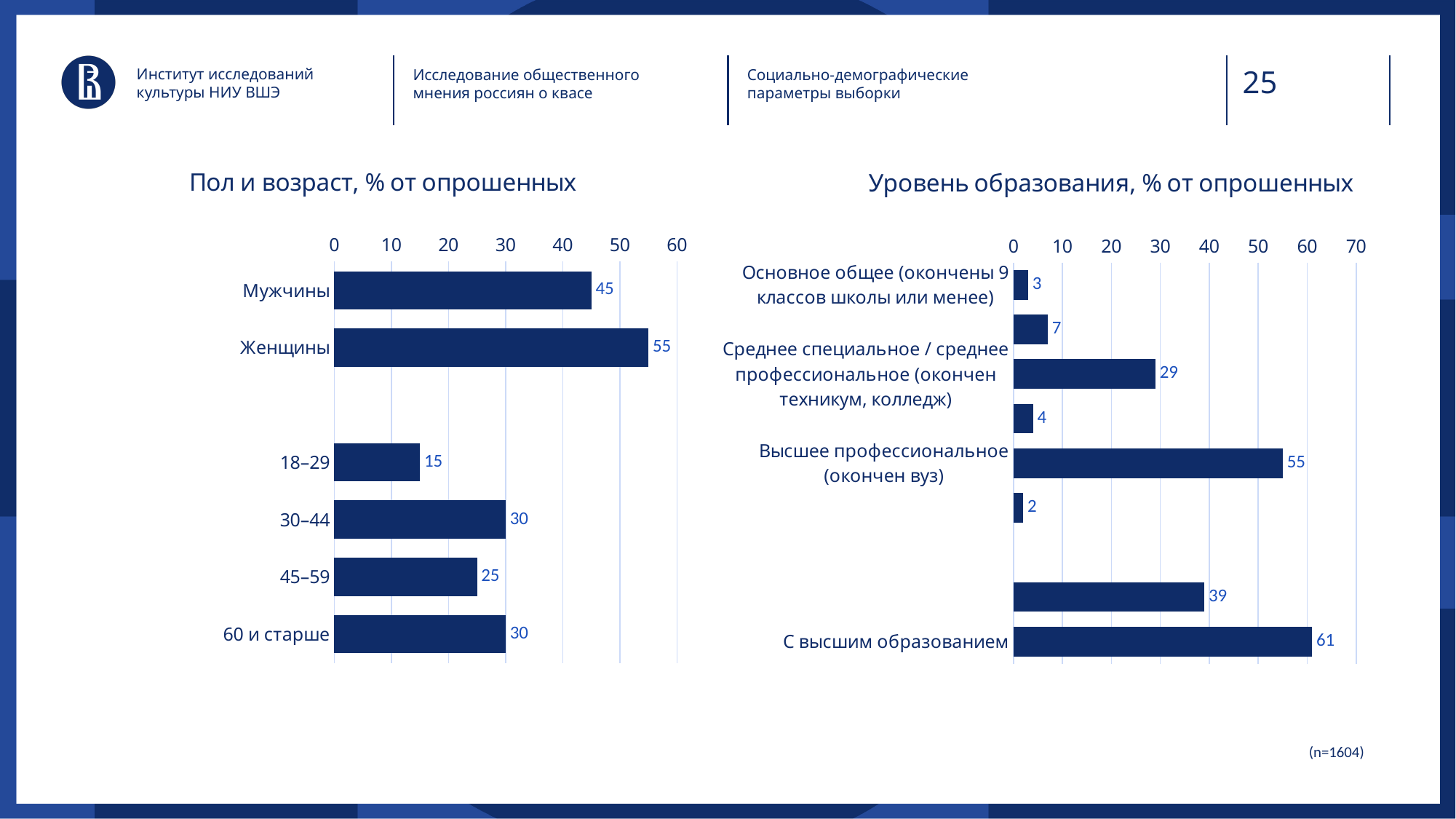
In the chart 'Уровень образования, % от опрошенных', what is the value for 'С высшим образованием'? 61 In the chart 'Пол и возраст, % от опрошенных', what is the value for 18–29? 15 In the chart 'Пол и возраст, % от опрошенных', what is the difference between the values for Женщины and Мужчины? 10 In the chart 'Уровень образования, % от опрошенных', what is the largest value shown? 61 In the chart 'Уровень образования, % от опрошенных', what is the smallest value shown? 2 In the chart 'Уровень образования, % от опрошенных', what is the highest tick on the horizontal axis? 70 In the chart 'Пол и возраст, % от опрошенных', what is the value for Женщины? 55 In the chart 'Пол и возраст, % от опрошенных', how many bars are plotted? 6 In the chart 'Пол и возраст, % от опрошенных', which age group has the lowest value? 18–29 In the chart 'Пол и возраст, % от опрошенных', which is larger, the value for 30–44 or the value for 45–59? 30–44 What kind of chart is 'Пол и возраст, % от опрошенных'? bar chart In the chart 'Уровень образования, % от опрошенных', what is the value for 'Основное общее (окончены 9 классов школы или менее)'? 3